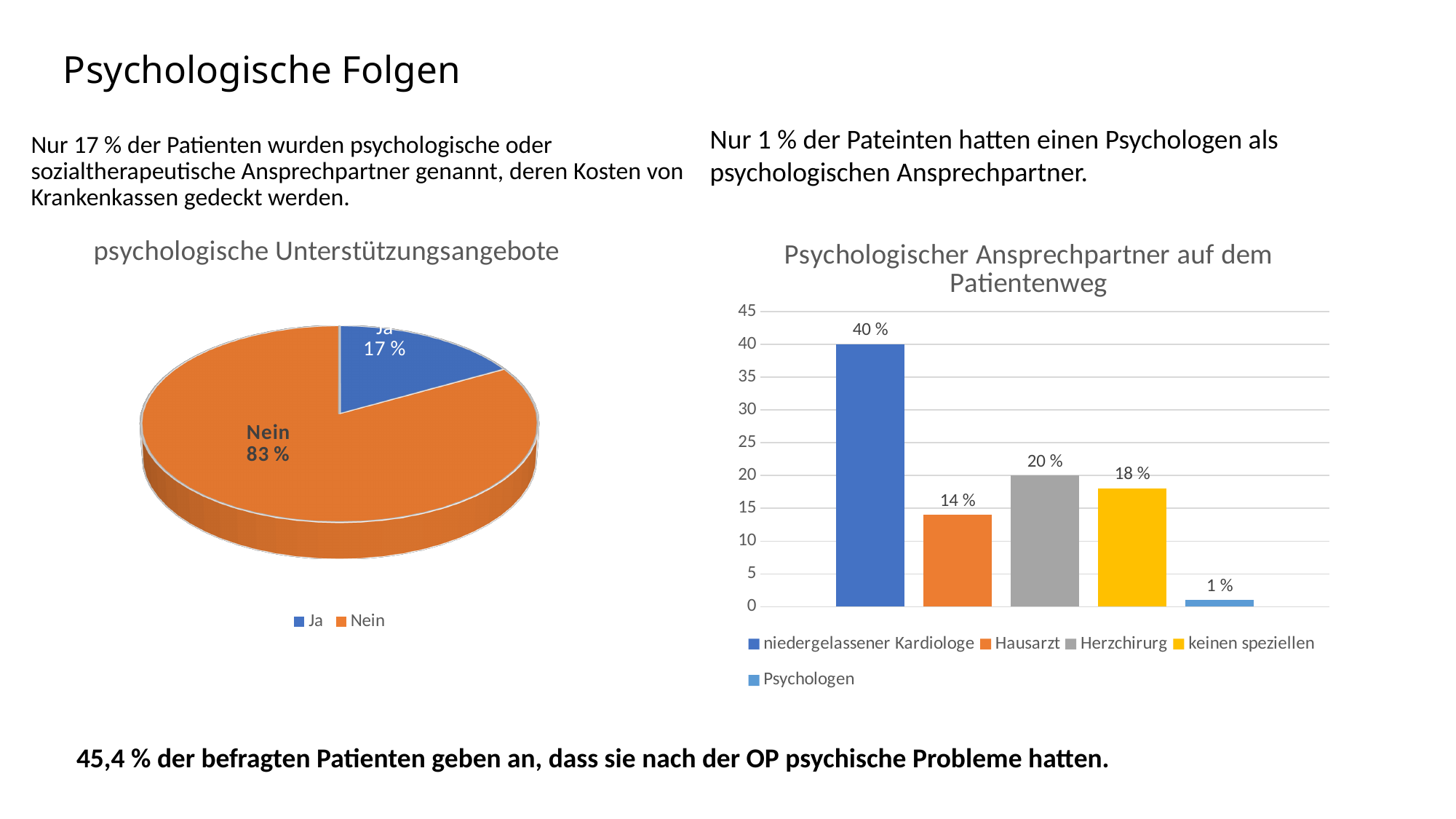
What kind of chart is 'Psychologischer Ansprechpartner auf dem Patientenweg'? bar chart In the chart 'psychologische Unterstützungsangebote', what share of the pie is 'Nein'? 83 % In the chart 'Psychologischer Ansprechpartner auf dem Patientenweg', what is the difference between 'niedergelassener Kardiologe' and 'keinen speziellen'? 22 % In the chart 'psychologische Unterstützungsangebote', what share of the pie is 'Ja'? 17 % What kind of chart is 'psychologische Unterstützungsangebote'? pie chart In the chart 'Psychologischer Ansprechpartner auf dem Patientenweg', what is the value for 'Herzchirurg'? 20 % In the chart 'Psychologischer Ansprechpartner auf dem Patientenweg', which is larger: 'Herzchirurg' or 'keinen speziellen'? Herzchirurg In the chart 'Psychologischer Ansprechpartner auf dem Patientenweg', which category has the highest value? niedergelassener Kardiologe In the chart 'Psychologischer Ansprechpartner auf dem Patientenweg', which category has the lowest value? Psychologen How many bars are shown in the chart 'Psychologischer Ansprechpartner auf dem Patientenweg'? 5 In the chart 'Psychologischer Ansprechpartner auf dem Patientenweg', what is the value for 'Hausarzt'? 14 % How many entries does the legend of the chart 'psychologische Unterstützungsangebote' list? 2